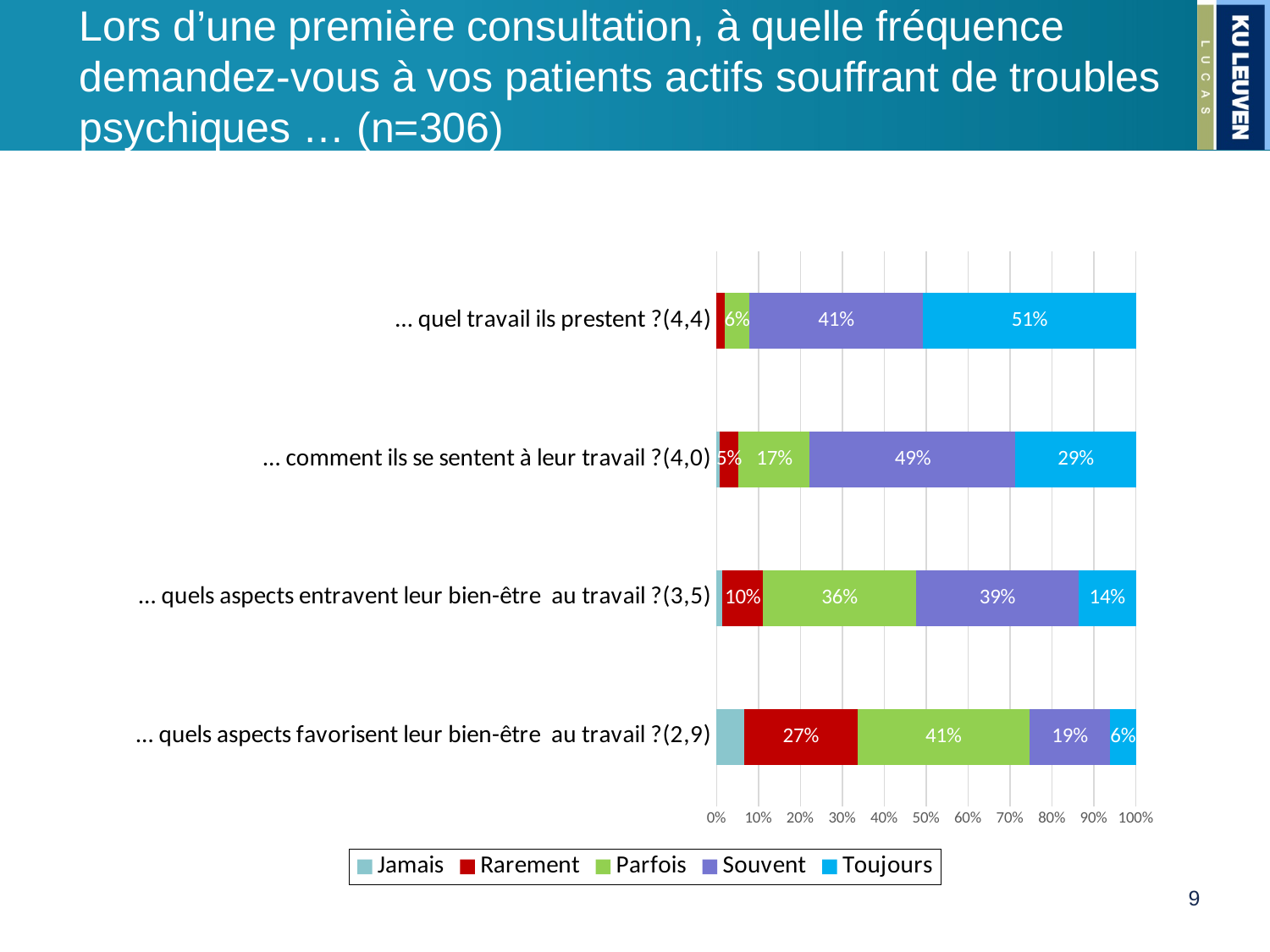
How many categories (questions) are shown on the chart? 4 What is the "Rarement" value for "... quels aspects favorisent leur bien-être au travail ?(2,9)"? 27% What percentage of respondents answered "Toujours" for "... quel travail ils prestent ?(4,4)"? 51% Which category has the highest "Toujours" value? ... quel travail ils prestent ?(4,4) What is the difference between the "Toujours" values for "... quel travail ils prestent ?(4,4)" and "... comment ils se sentent à leur travail ?(4,0)"? 22% Which colour represents "Souvent" in the legend? Purple How many series does the legend list? 5 Which is larger: the "Parfois" value for "... quels aspects favorisent leur bien-être au travail ?(2,9)" or the "Parfois" value for "... quels aspects entravent leur bien-être au travail ?(3,5)"? ... quels aspects favorisent leur bien-être au travail ?(2,9) What is the "Souvent" value for "... comment ils se sentent à leur travail ?(4,0)"? 49% Which category has the lowest "Toujours" value? ... quels aspects favorisent leur bien-être au travail ?(2,9) What is the "Parfois" value for "... quels aspects entravent leur bien-être au travail ?(3,5)"? 36% What kind of chart is shown on the slide? Stacked bar chart